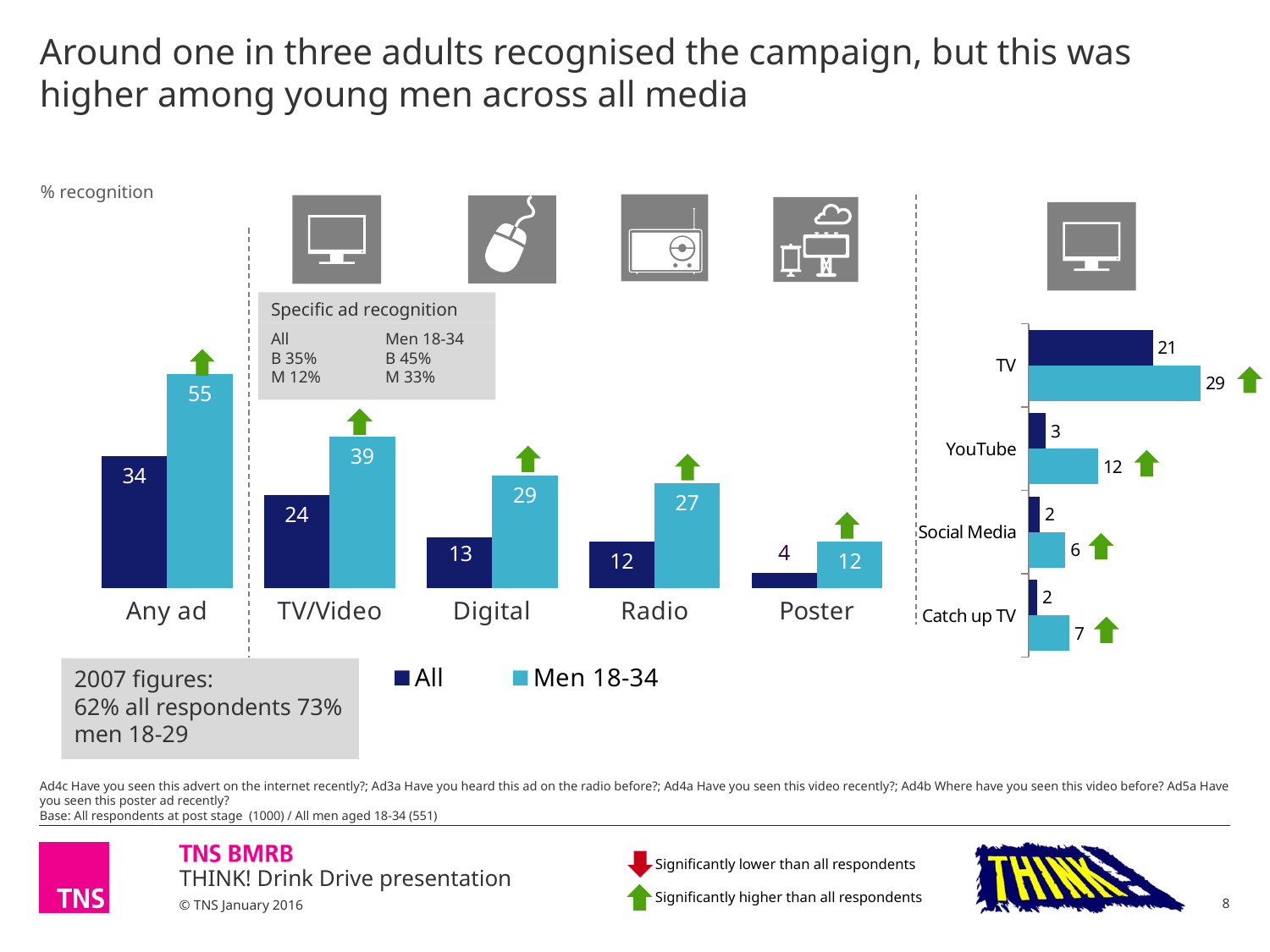
What type of chart is the chart on the right of the slide? Bar chart How many series does the legend of the left bar chart list? 2 In the left bar chart, what is the value for Men 18-34 for Any ad? 55 How many categories are shown on the x axis of the left bar chart? 5 In the left bar chart, which category has the highest value for Men 18-34? Any ad In the left bar chart, what is the value for All for Digital? 13 In the left bar chart, which is larger for TV/Video: All or Men 18-34? Men 18-34 In the left bar chart, what is the difference between Men 18-34 and All for Radio? 15 In the right bar chart, what is the value for Men 18-34 for TV? 29 In the right bar chart, which category has the highest value for All? TV In the left bar chart, which category has the lowest value for All? Poster In the right bar chart, what is the difference between Men 18-34 and All for YouTube? 9